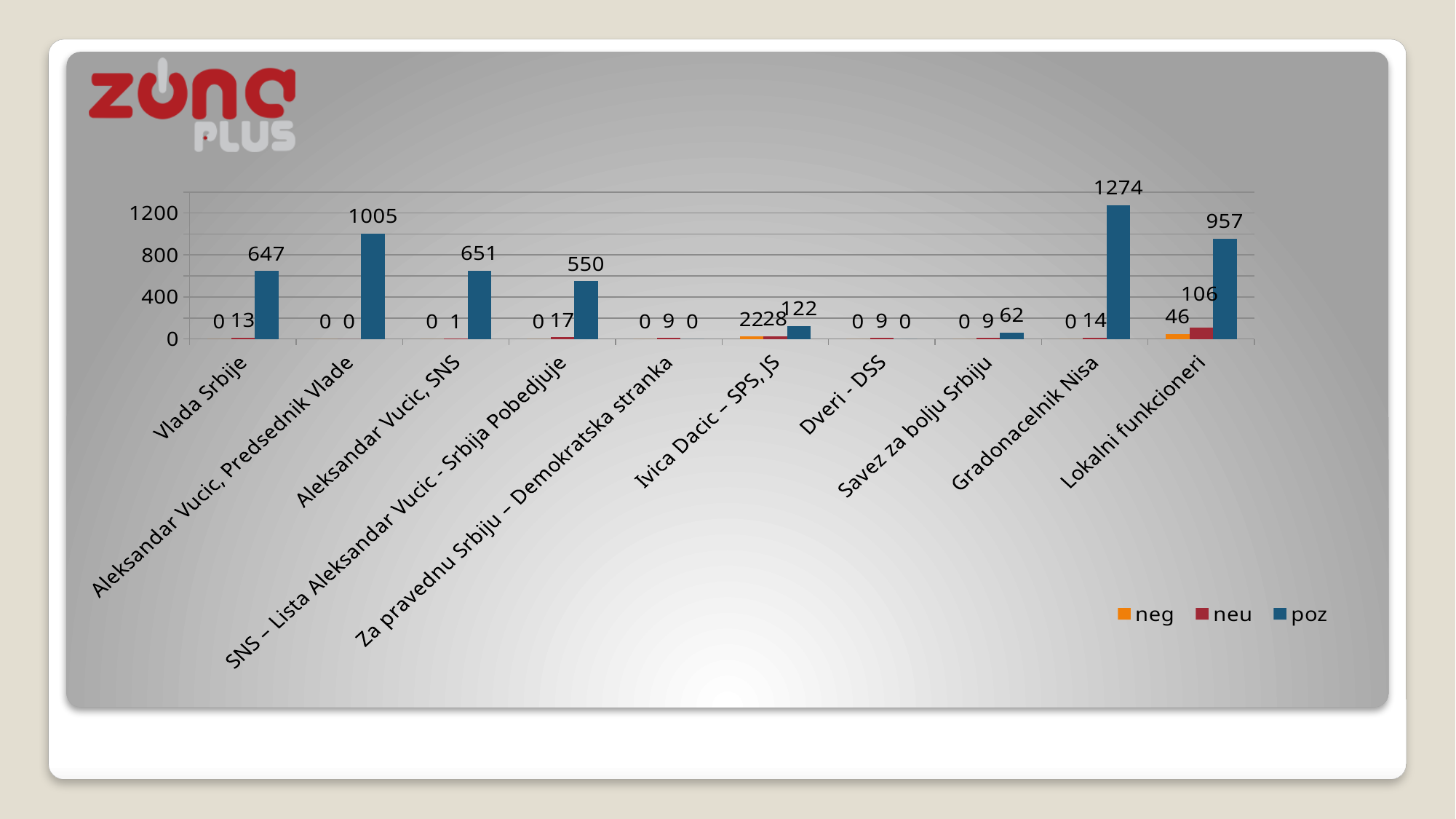
Which series is shown in blue in the legend? poz What is the difference between the poz values for Gradonacelnik Nisa and Lokalni funkcioneri? 317 How many series does the legend list? 3 What kind of chart is shown on the slide? Bar chart How many categories are shown on the x axis? 10 Which category has the highest poz value? Gradonacelnik Nisa Which category has the highest neu value? Lokalni funkcioneri What is the poz value for Aleksandar Vucic, Predsednik Vlade? 1005 What is the poz value for Gradonacelnik Nisa? 1274 Which is larger, the poz value for Vlada Srbije or the poz value for SNS – Lista Aleksandar Vucic - Srbija Pobedjuje? Vlada Srbije What is the neg value for Lokalni funkcioneri? 46 What is the neu value for Lokalni funkcioneri? 106